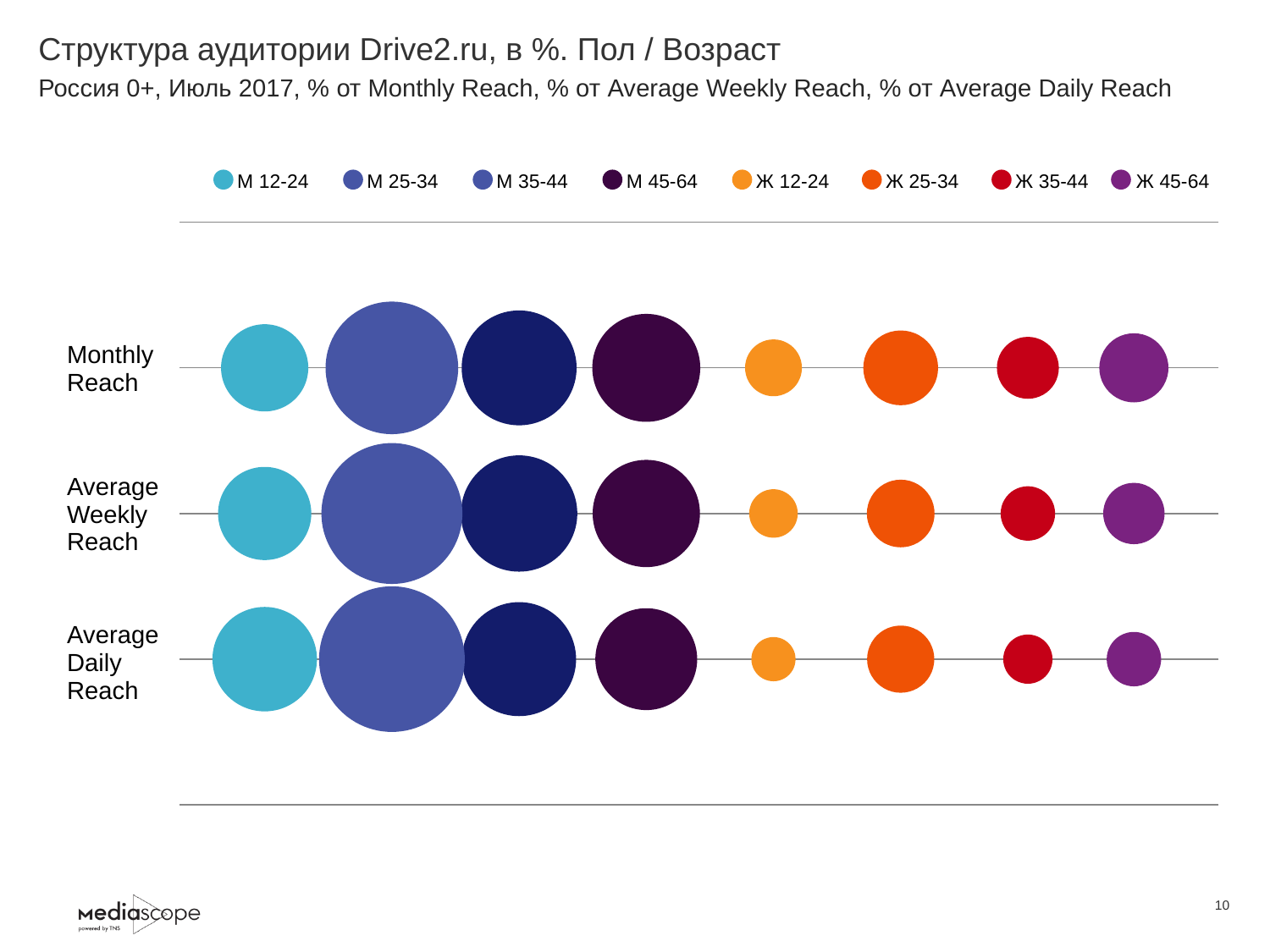
In the Average Daily Reach row, which bubble is larger: М 12-24 or Ж 45-64? М 12-24 In the Monthly Reach row, which bubble is larger: М 45-64 or Ж 25-34? М 45-64 What kind of chart is shown on the slide? bubble chart How many series does the legend list? 8 Which gender/age group has the largest bubble in the Monthly Reach row? М 25-34 Does the М 12-24 bubble get larger or smaller going from Monthly Reach to Average Daily Reach? larger What colour is the М 12-24 series in the legend? light blue What is the title of the chart on the slide? Структура аудитории Drive2.ru, в %. Пол / Возраст In the Average Weekly Reach row, which bubble is larger: М 25-34 or Ж 12-24? М 25-34 Which gender/age group has the largest bubble in the Average Daily Reach row? М 25-34 How many reach categories (rows) are plotted on the chart? 3 Which gender/age group has the smallest bubble in the Monthly Reach row? Ж 12-24